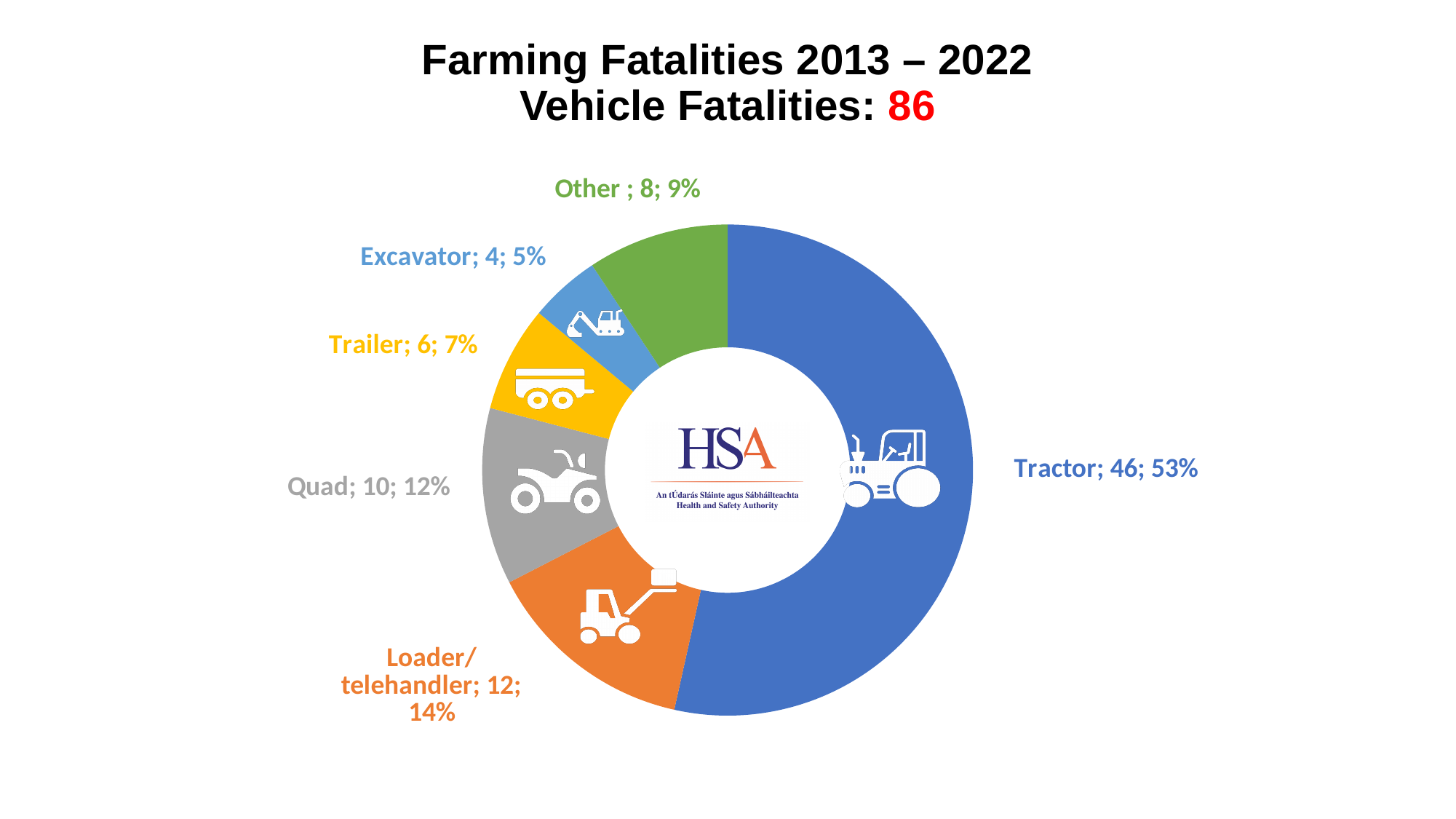
Which has more fatalities, Trailer or Other? Other How many categories are shown in the chart? 6 What share of vehicle fatalities does the Excavator slice represent? 5% Which vehicle category has the lowest number of fatalities? Excavator Which vehicle category has the highest number of fatalities? Tractor What kind of chart is shown on the slide? Pie chart (doughnut) What is the total number of vehicle fatalities stated in the title? 86 How many fatalities are shown for Loader/telehandler? 12 What colour is the Trailer slice? Yellow What percentage of vehicle fatalities does the Quad slice represent? 12% What is the difference in fatalities between Tractor and Quad? 36 How many vehicle fatalities are attributed to tractors? 46